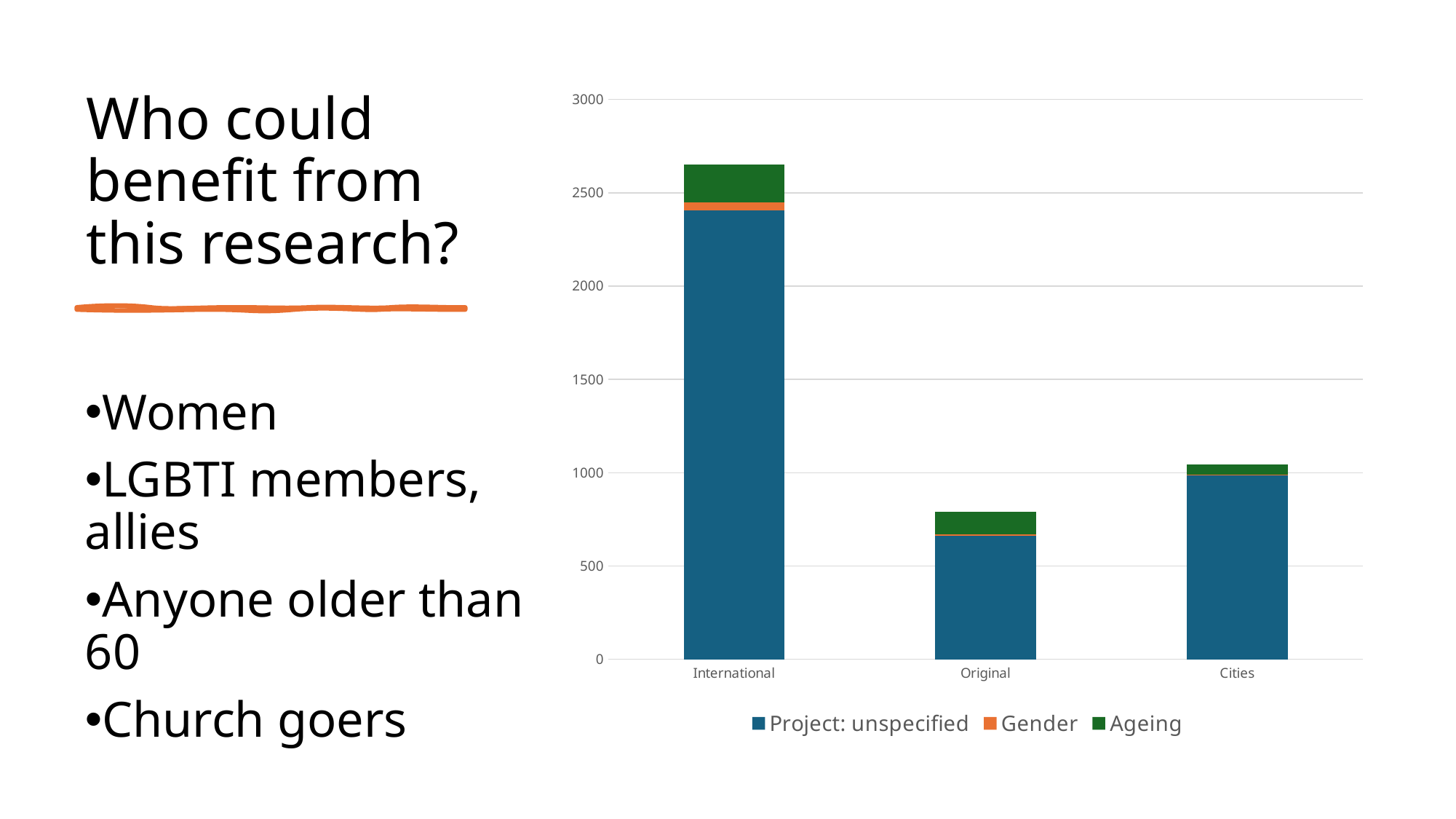
Is the total stacked value for International greater or less than 2500? greater Which category has the tallest stacked bar? International Which category has the shortest stacked bar? Original How many categories are shown on the x axis of the chart? 3 Is the 'Project: unspecified' value for International greater or less than 2000? greater Which series is shown in orange in the chart's legend? Gender How many series does the chart's legend list? 3 Is the total stacked value for Original greater or less than 1000? less Which stacked bar is taller, Cities or Original? Cities Which series is shown in green in the chart's legend? Ageing What kind of chart is shown on the slide? Stacked bar chart